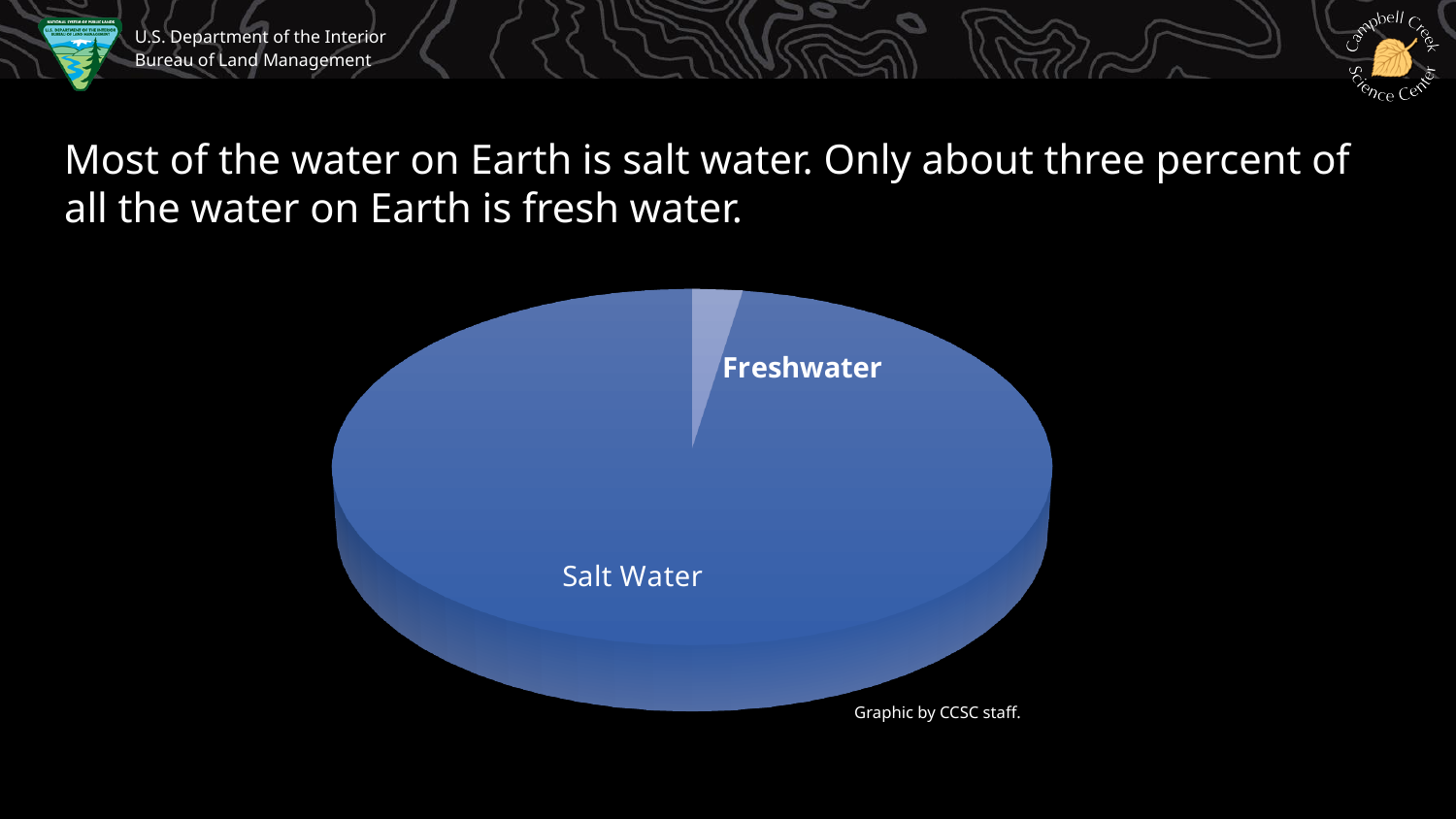
How many slices does the pie chart have? 2 Which slice of the pie chart is the smallest? Freshwater Does the Salt Water slice take up more or less than half of the pie? More What are the labels of the two slices in the pie chart? Freshwater and Salt Water Which slice is larger, Salt Water or Freshwater? Salt Water Which slice of the pie chart is the largest? Salt Water Who is credited for the graphic on the slide? CCSC staff What kind of chart is shown on the slide? Pie chart Does the Freshwater slice take up more or less than half of the pie? Less